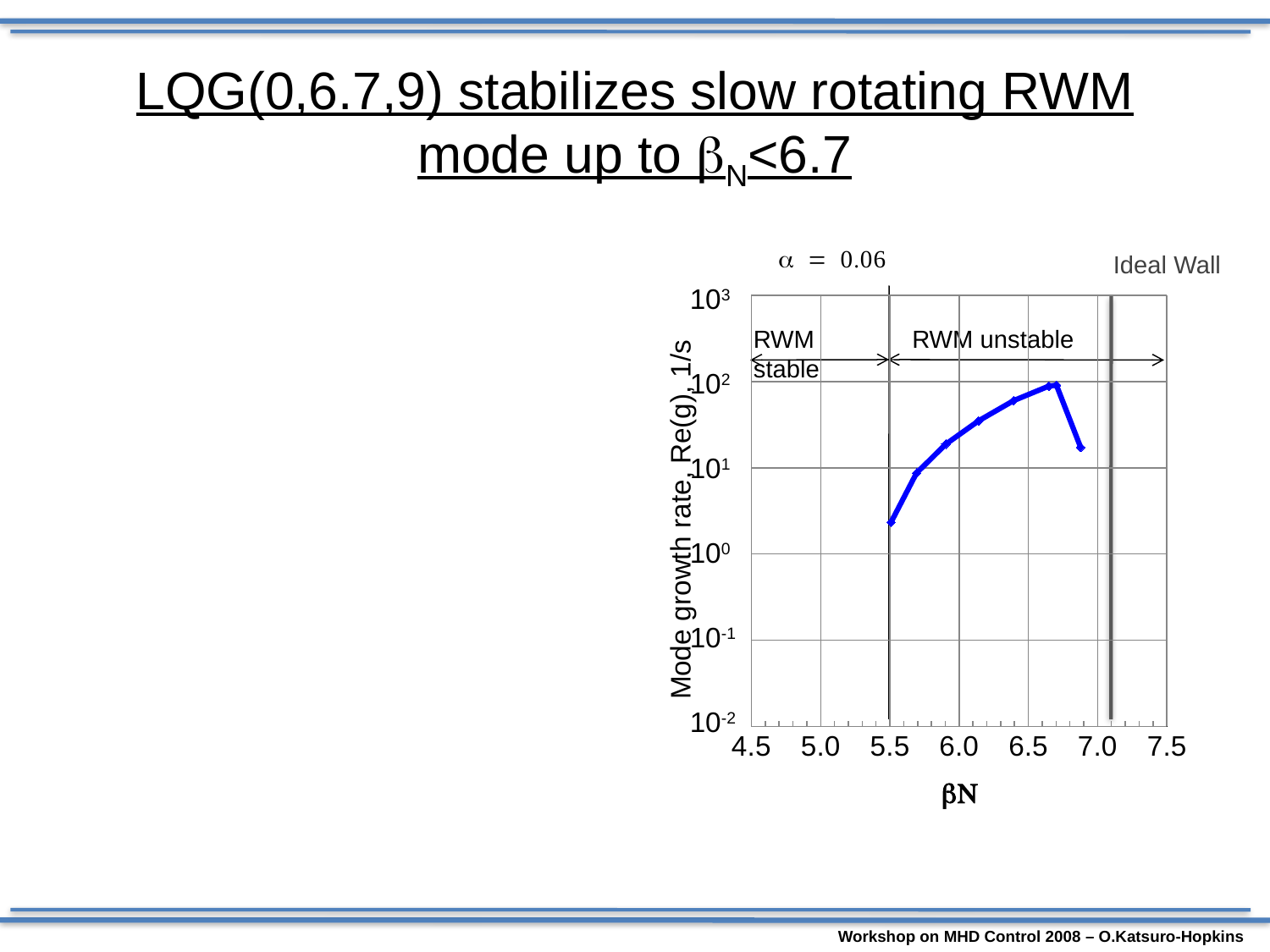
What kind of chart is shown on the slide? line chart What is the label of the y axis of the chart? Mode growth rate, Re(g), 1/s Is the mode growth rate at βN = 5.5 greater or less than 10^1? less What is the label of the x axis of the chart? βN At which βN value does the plotted mode growth rate reach its highest point? 6.7 At which βN value is the plotted mode growth rate lowest? 5.5 Is the mode growth rate at βN = 5.5 greater or less than 10^0? greater Is the mode growth rate at βN = 6.1 greater or less than 10^1? greater Does the mode growth rate rise or fall as βN increases from 5.5 to 6.7? rise Which has the larger mode growth rate, βN = 6.7 or βN = 6.9? βN = 6.7